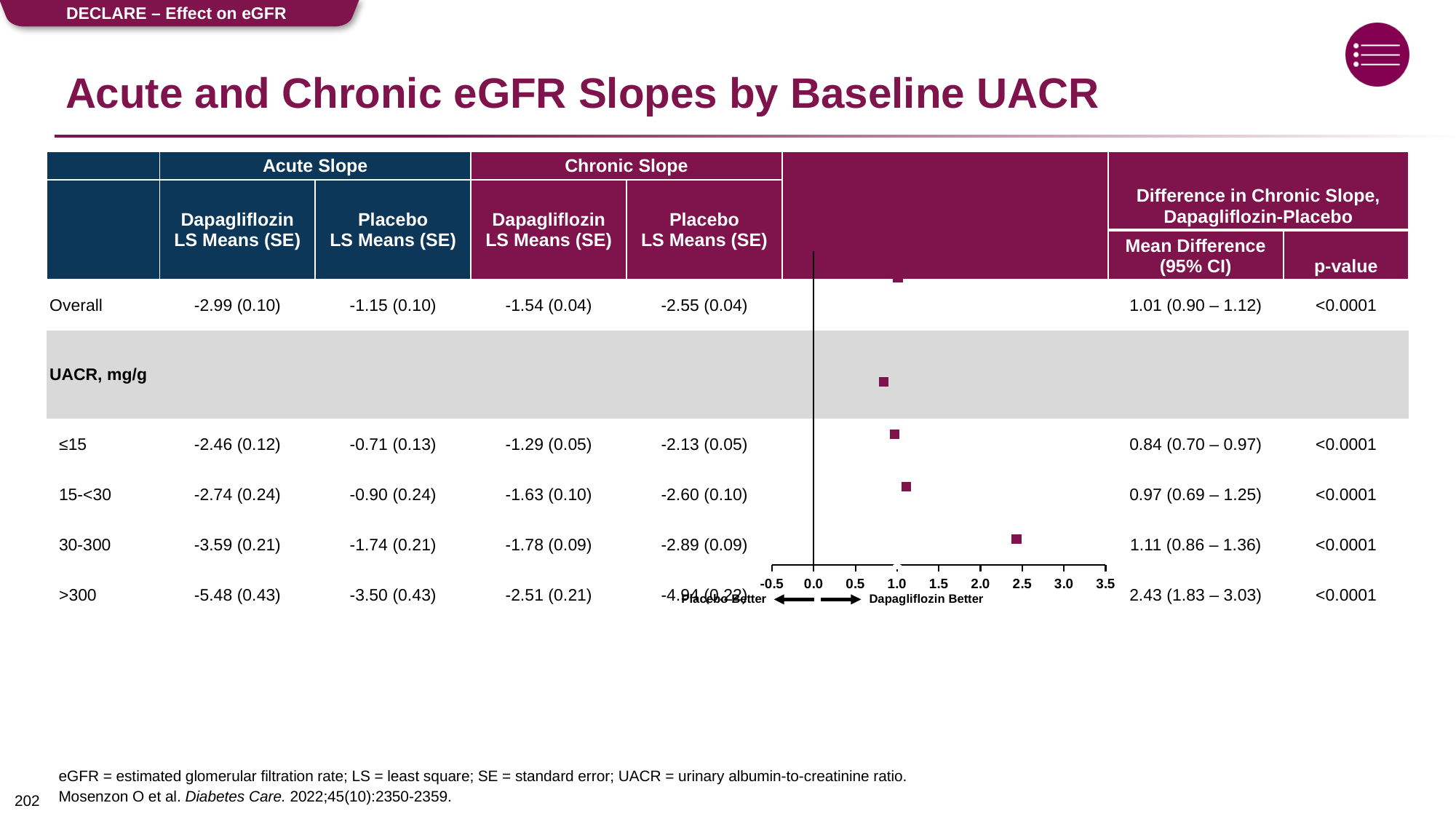
Which has a larger mean difference in chronic slope: the 15-<30 subgroup or the 30-300 subgroup? 30-300 Which direction on the chart's x axis is labelled 'Dapagliflozin Better'? right (toward higher values) What kind of chart is used to display the mean differences? scatter chart What is the mean difference in chronic slope (Dapagliflozin-Placebo) for the Overall group? 1.01 (0.90 – 1.12) Is the plotted mean difference for the >300 subgroup greater or less than 2.0? greater How many data points are plotted in the chart? 5 What is the mean difference in chronic slope for the UACR >300 mg/g subgroup? 2.43 (1.83 – 3.03) What is the difference between the mean difference in chronic slope for the >300 subgroup and the 30-300 subgroup? 1.32 What is the highest value shown on the chart's x axis? 3.5 Which UACR subgroup has the smallest mean difference in chronic slope? ≤15 Which UACR subgroup has the largest mean difference in chronic slope? >300 What is the mean difference in chronic slope for the UACR ≤15 mg/g subgroup? 0.84 (0.70 – 0.97)